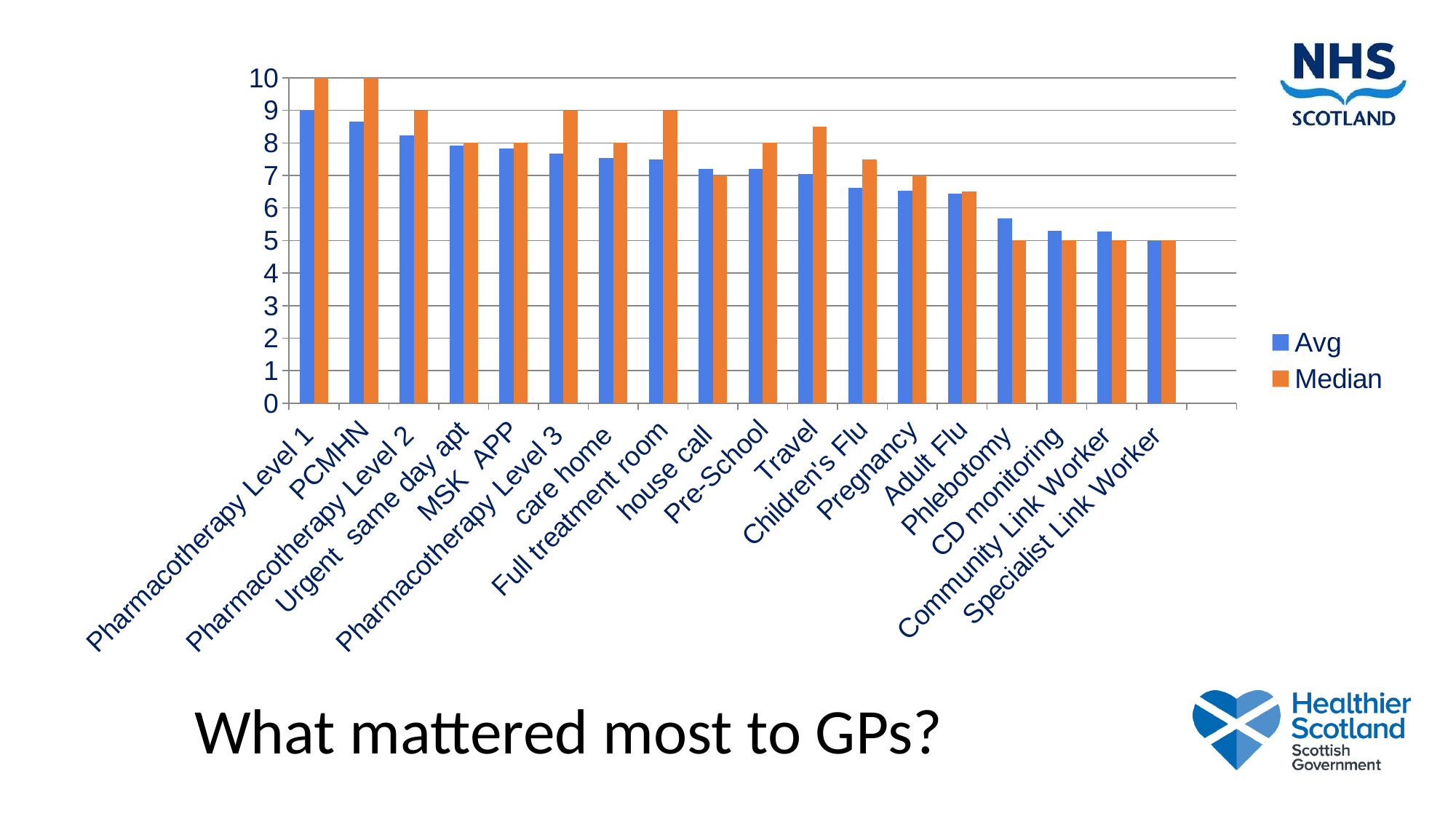
What is the Avg value for Pharmacotherapy Level 1? 9 What is the Median value for Pharmacotherapy Level 1? 10 How many series does the legend list? 2 Do the Avg values generally rise or fall from left to right along the x axis? fall For Full treatment room, which is larger, the Avg or the Median? Median Which category has the highest Avg value? Pharmacotherapy Level 1 Is the Avg value for PCMHN greater or less than 8? greater What is the Median value for Phlebotomy? 5 What kind of chart is shown on the slide? bar chart What is the Median value for house call? 7 How many categories are shown on the x axis? 18 What is the difference between the Median for Pharmacotherapy Level 1 and the Median for house call? 3